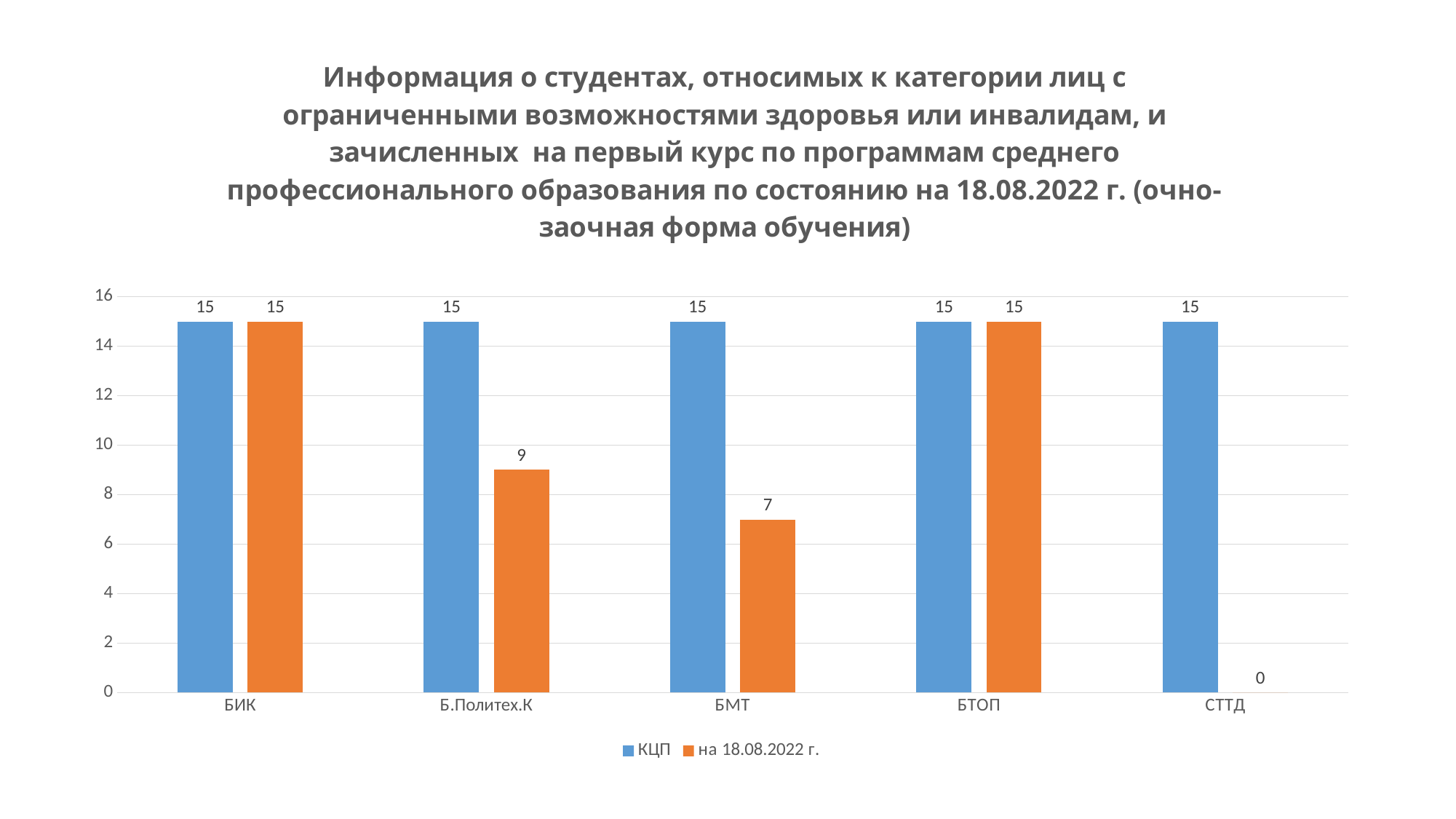
What is the difference between the КЦП value and the 'на 18.08.2022 г.' value for БМТ? 8 What is the value for Б.Политех.К in the 'на 18.08.2022 г.' series? 9 What is the difference between the 'на 18.08.2022 г.' values for Б.Политех.К and БМТ? 2 What is the value for СТТД in the 'на 18.08.2022 г.' series? 0 Which is larger: the 'на 18.08.2022 г.' value for Б.Политех.К or for БМТ? Б.Политех.К What is the КЦП value for БТОП? 15 Which category has the lowest value in the 'на 18.08.2022 г.' series? СТТД How many categories are shown on the x axis? 5 What is the value for БМТ in the 'на 18.08.2022 г.' series? 7 Is the 'на 18.08.2022 г.' value for БМТ greater or less than 10? less How many series does the legend list? 2 What kind of chart is shown on the slide? bar chart